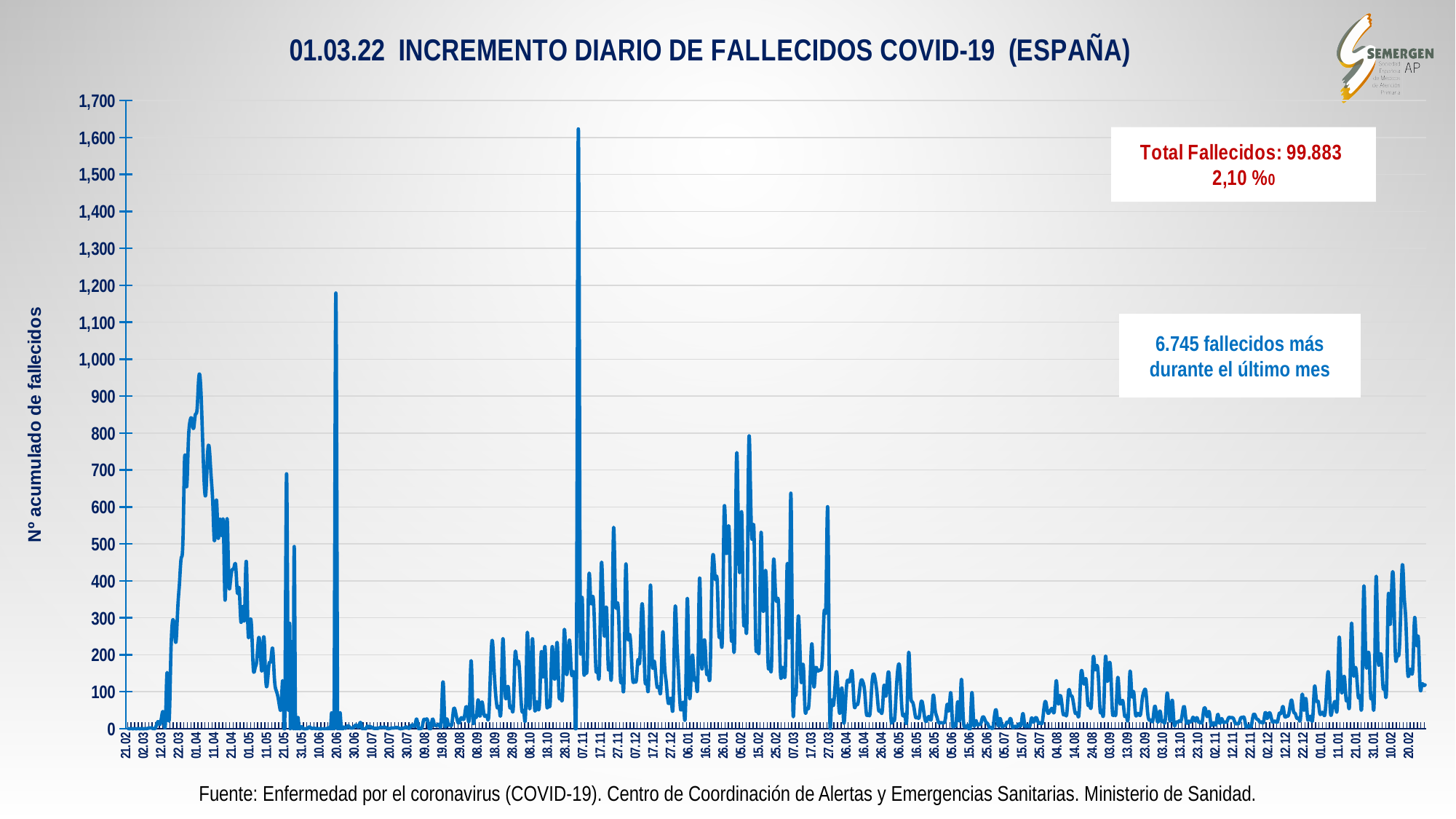
Which is larger, the spike around 07.11 or the spike around 20.06? the spike around 07.11 Is the peak of the first wave (around 01.04) greater or less than 900? greater How many data series are plotted in the chart? 1 What is the label of the vertical axis? Nº acumulado de fallecidos Do the values rise or fall between 01.04 and 11.05? fall What is the title of the chart? 01.03.22 INCREMENTO DIARIO DE FALLECIDOS COVID-19 (ESPAÑA) What is the highest value shown on the vertical axis? 1,700 Do the values rise or fall between 12.12 and 31.01 at the right end of the chart? rise Is the highest spike in the chart (around 07.11) greater or less than 1,500? greater Is the peak of the first wave (around 01.04) greater or less than 1,000? less What kind of chart is shown on the slide? line chart